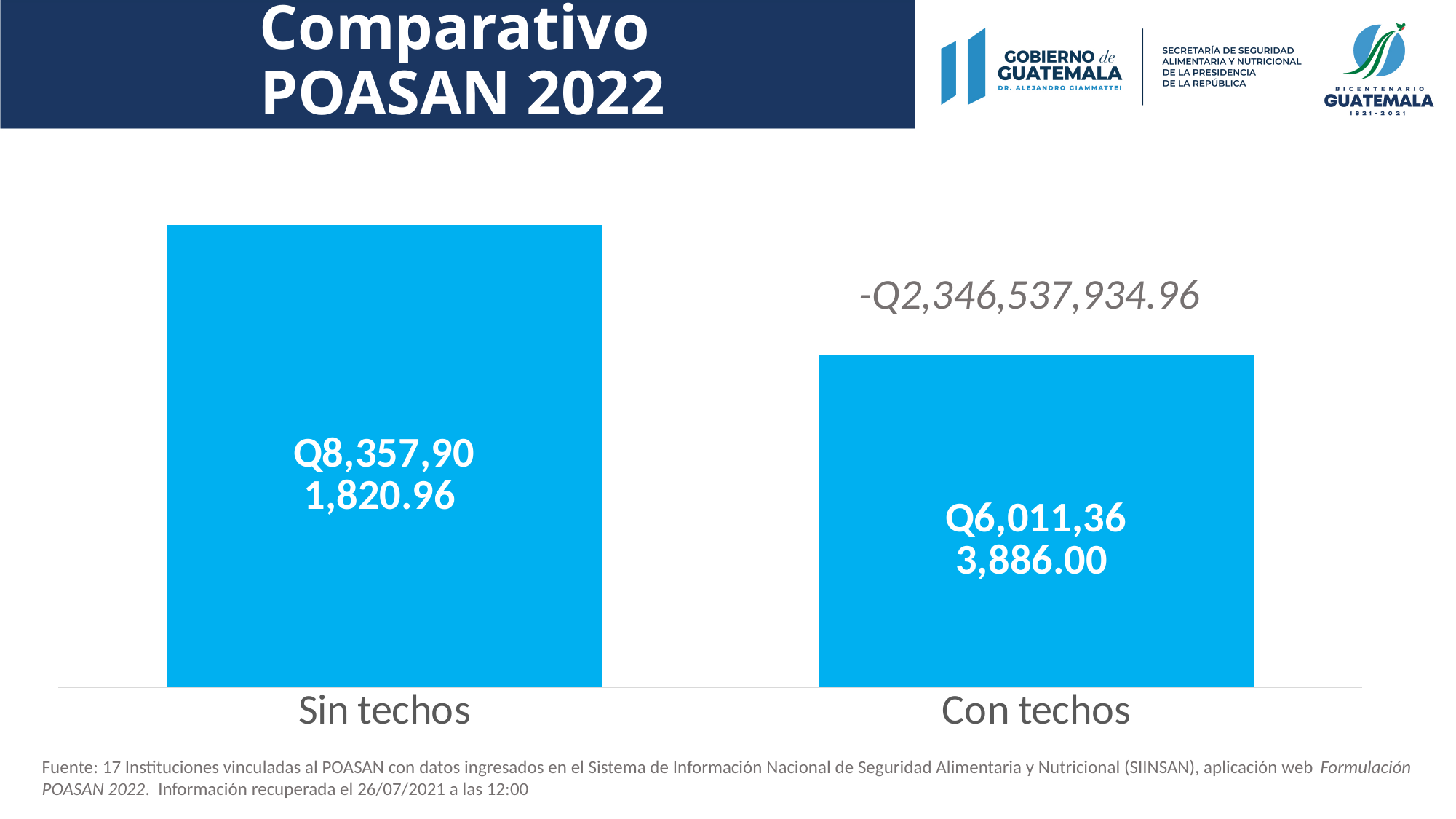
What kind of chart is shown on the slide? Bar chart What is the title of the slide containing the chart? Comparativo POASAN 2022 What is the difference between the value for Sin techos and the value for Con techos? Q2,346,537,934.96 What difference is annotated above the Con techos bar? -Q2,346,537,934.96 Which category has the highest value? Sin techos Which is larger, the value for Sin techos or the value for Con techos? Sin techos Which category has the lowest value? Con techos Do the values rise or fall from Sin techos to Con techos? Fall What is the value for Con techos? Q6,011,363,886.00 What is the value for Sin techos? Q8,357,901,820.96 How many categories are shown in the chart? 2